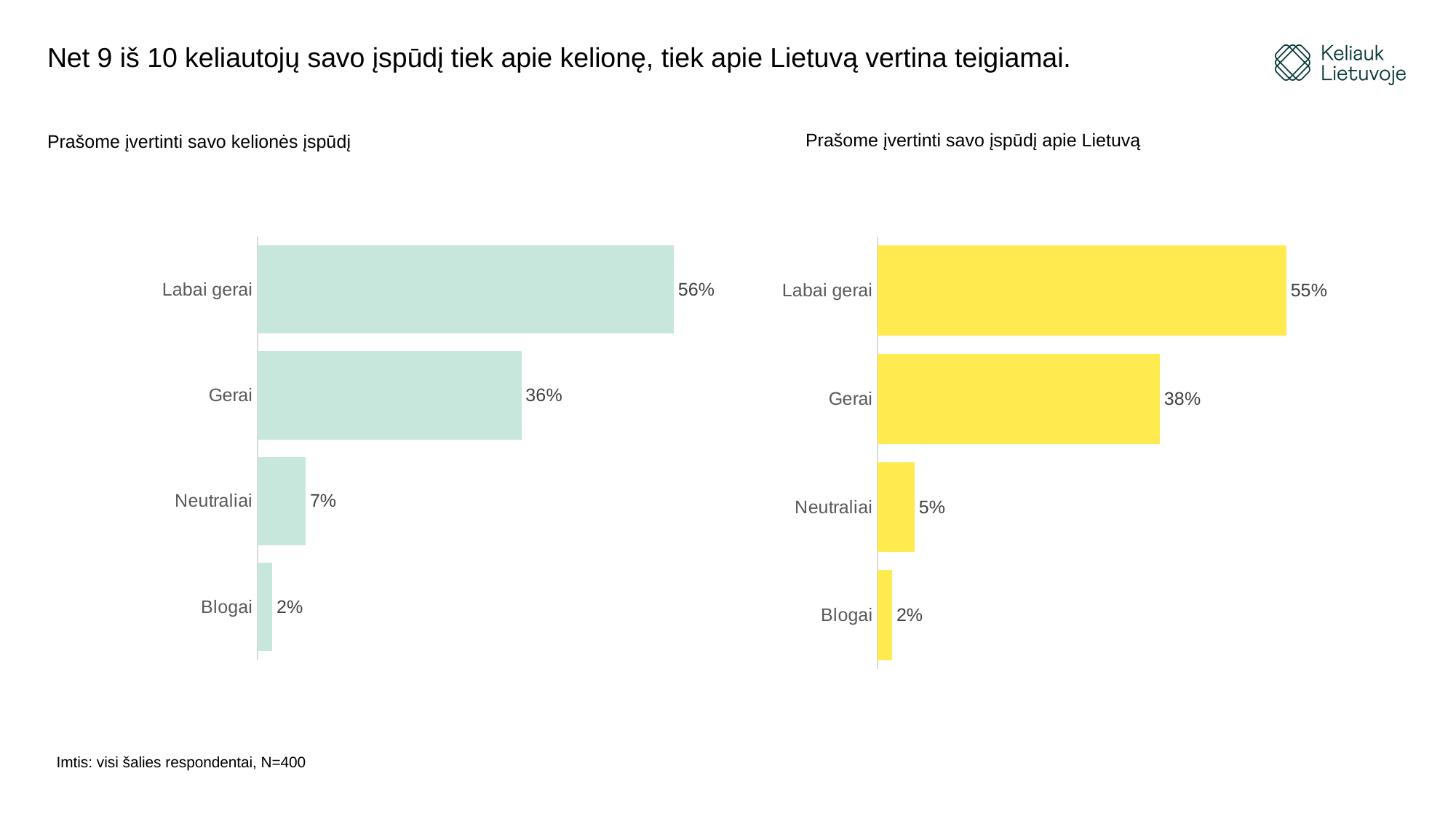
What colour are the bars in the right chart (Prašome įvertinti savo įspūdį apie Lietuvą)? Yellow In the right chart (Prašome įvertinti savo įspūdį apie Lietuvą), what is the difference between Gerai and Neutraliai? 33% In the left chart (Prašome įvertinti savo kelionės įspūdį), what is the value for Neutraliai? 7% What kind of chart is the right chart (Prašome įvertinti savo įspūdį apie Lietuvą)? Bar chart In the right chart (Prašome įvertinti savo įspūdį apie Lietuvą), what is the value for Blogai? 2% Which is larger: Neutraliai in the left chart or Neutraliai in the right chart? Neutraliai in the left chart How many categories does the left chart (Prašome įvertinti savo kelionės įspūdį) show? 4 In the left chart (Prašome įvertinti savo kelionės įspūdį), what is the value for Labai gerai? 56% In the right chart (Prašome įvertinti savo įspūdį apie Lietuvą), what is the value for Gerai? 38% In the left chart (Prašome įvertinti savo kelionės įspūdį), which category has the lowest value? Blogai In the right chart (Prašome įvertinti savo įspūdį apie Lietuvą), which category has the highest value? Labai gerai In the left chart (Prašome įvertinti savo kelionės įspūdį), what is the difference between Labai gerai and Gerai? 20%